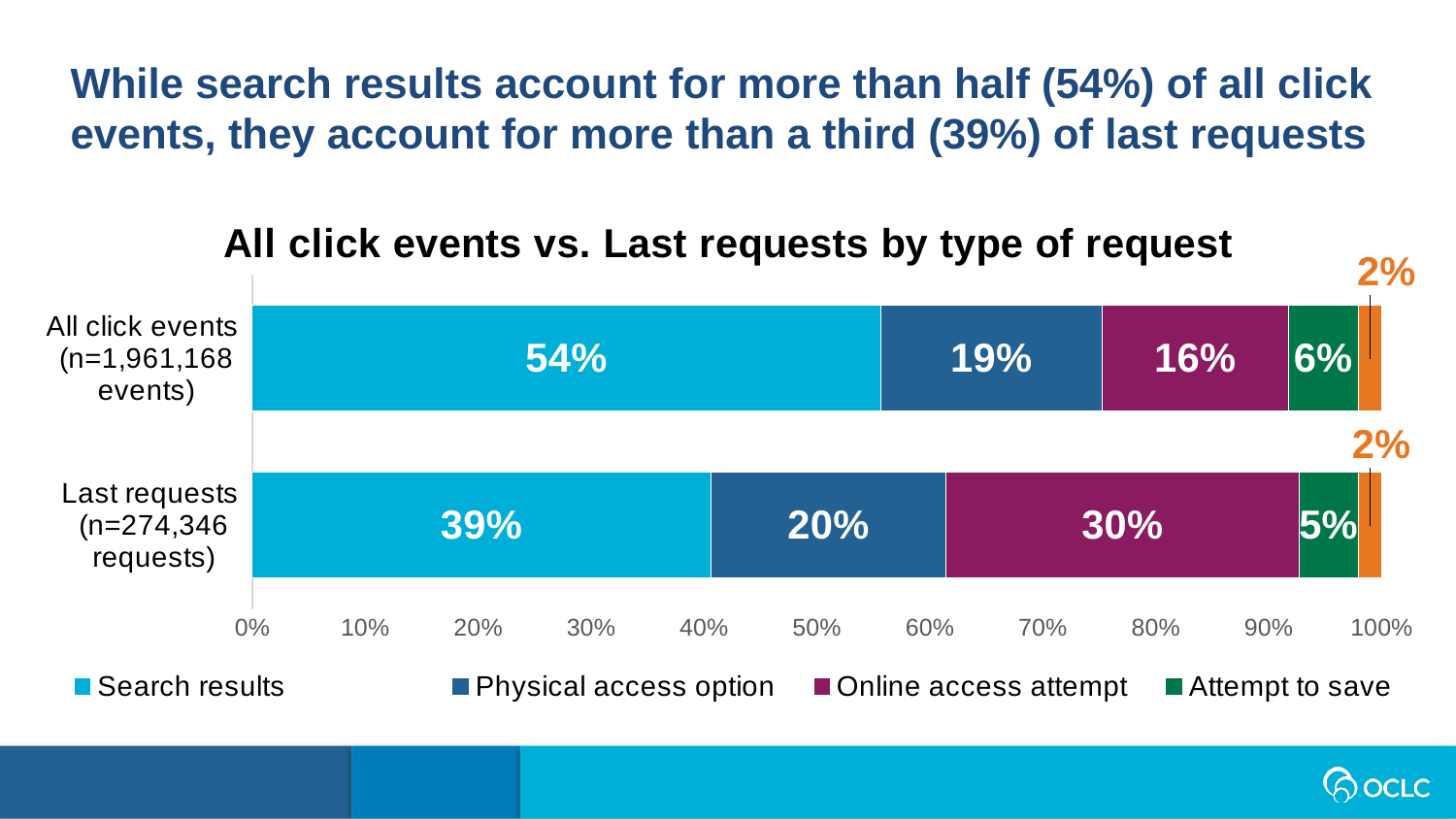
What is the title of the chart? All click events vs. Last requests by type of request What percentage of last requests are search results? 39% What percentage of all click events are attempts to save? 6% How many bars (categories) are shown in the chart? 2 Which segment is the largest in the Last requests bar? Search results What kind of chart is shown on the slide? Stacked bar chart How many series does the legend list? 4 Which is larger: the online access attempt share of all click events or of last requests? Last requests What percentage of last requests are online access attempts? 30% What percentage of all click events are physical access options? 19% What percentage of all click events are search results? 54% What is the difference between the search results share of all click events and of last requests? 15 percentage points